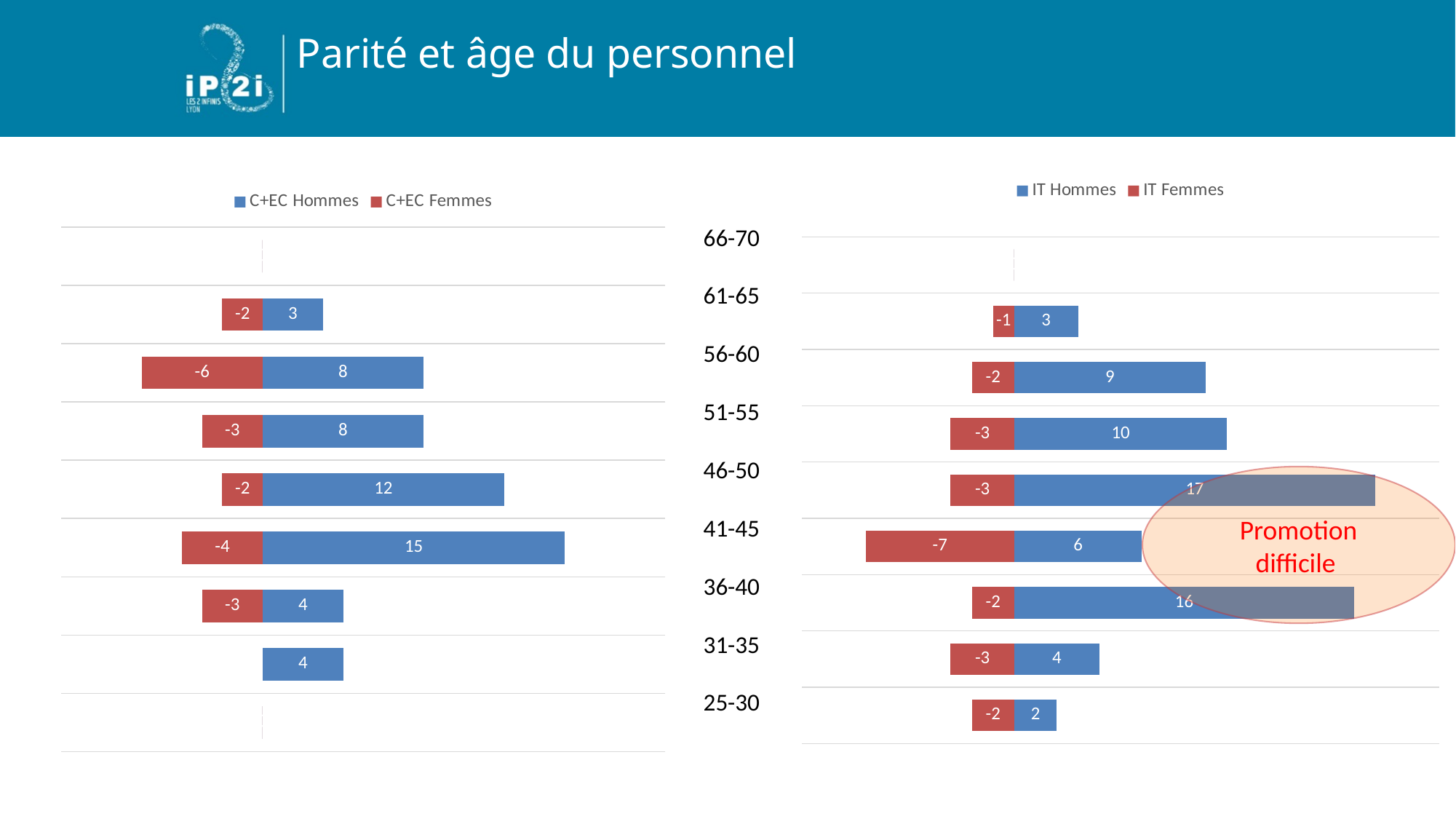
What type of chart is the left chart (C+EC)? Bar chart In the right chart (IT), what is the value for IT Hommes in the 46-50 age group? 17 In the right chart (IT), which age group has the highest IT Hommes value? 46-50 In the right chart (IT), what is the difference between the IT Hommes values for the 46-50 and 41-45 age groups? 11 In the left chart (C+EC), which age group has the highest C+EC Hommes value? 41-45 How many series does the legend of the right chart (IT) list? 2 In the left chart (C+EC), what is the value for C+EC Femmes in the 56-60 age group? -6 In the left chart (C+EC), which is larger, the C+EC Hommes value for 46-50 or for 36-40? 46-50 What text is written in the highlighted oval on the right chart (IT)? Promotion difficile In the left chart (C+EC), what is the value for C+EC Hommes in the 41-45 age group? 15 In the right chart (IT), what is the value for IT Femmes in the 41-45 age group? -7